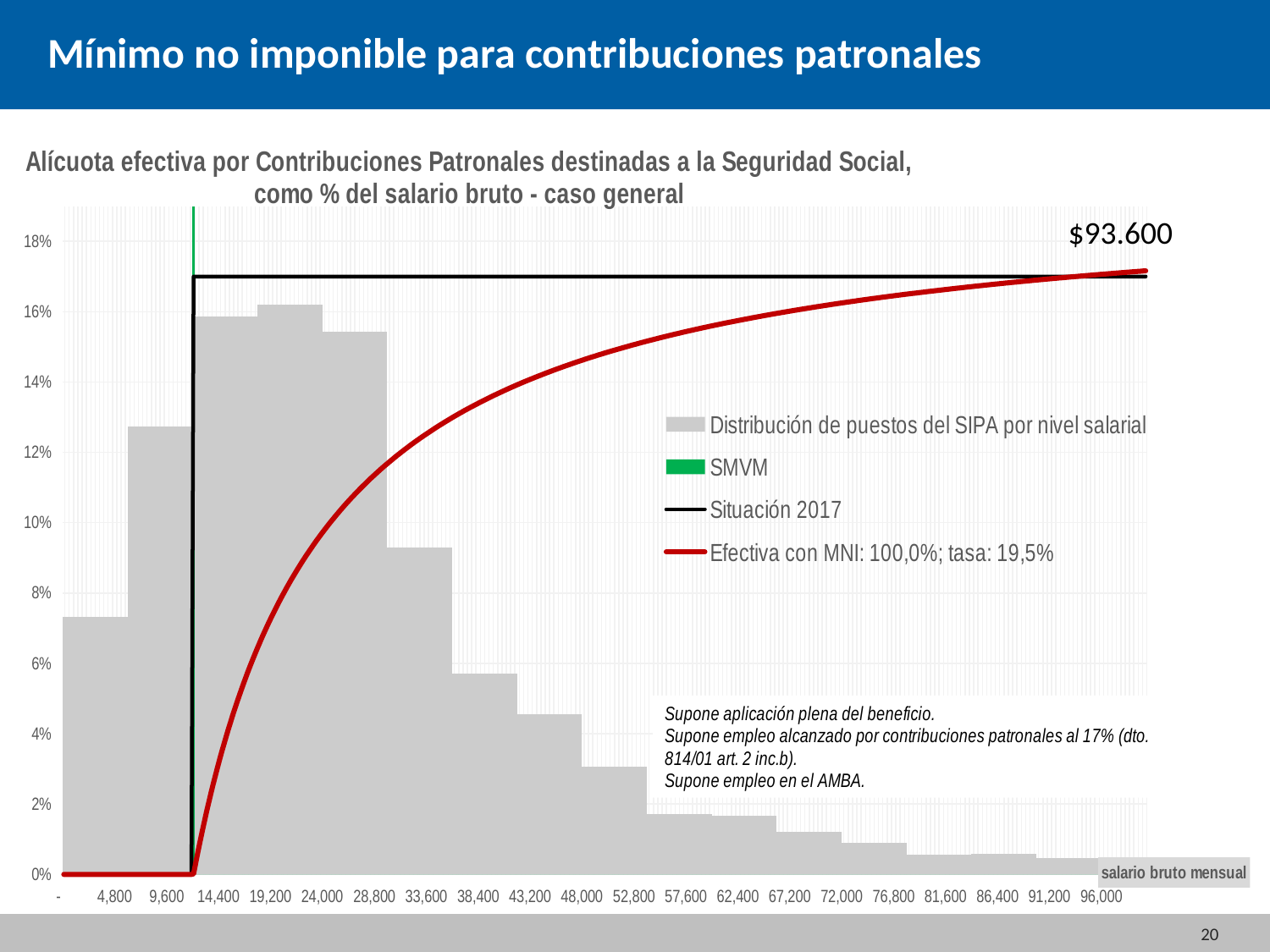
What is the label of the red line series in the legend? Efectiva con MNI: 100,0%; tasa: 19,5% Is the gray bar for the 19,200 salary level greater or less than 14%? greater What salary value is annotated at the top right of the chart? $93.600 How many series does the legend list? 4 Is the red 'Efectiva con MNI' line at the 14,400 salary level greater or less than 8%? less What kind of chart is this? Combined bar and line chart Which gray bar is taller, the one at 28,800 or the one at 33,600? 28,800 Does the red 'Efectiva con MNI' line rise or fall as salary increases along the x axis? Rises Is the gray bar for the 4,800 salary level greater or less than 8%? less What is the title of the chart? Alícuota efectiva por Contribuciones Patronales destinadas a la Seguridad Social, como % del salario bruto - caso general Which gray bar is lower, the one at 4,800 or the one at 9,600? 4,800